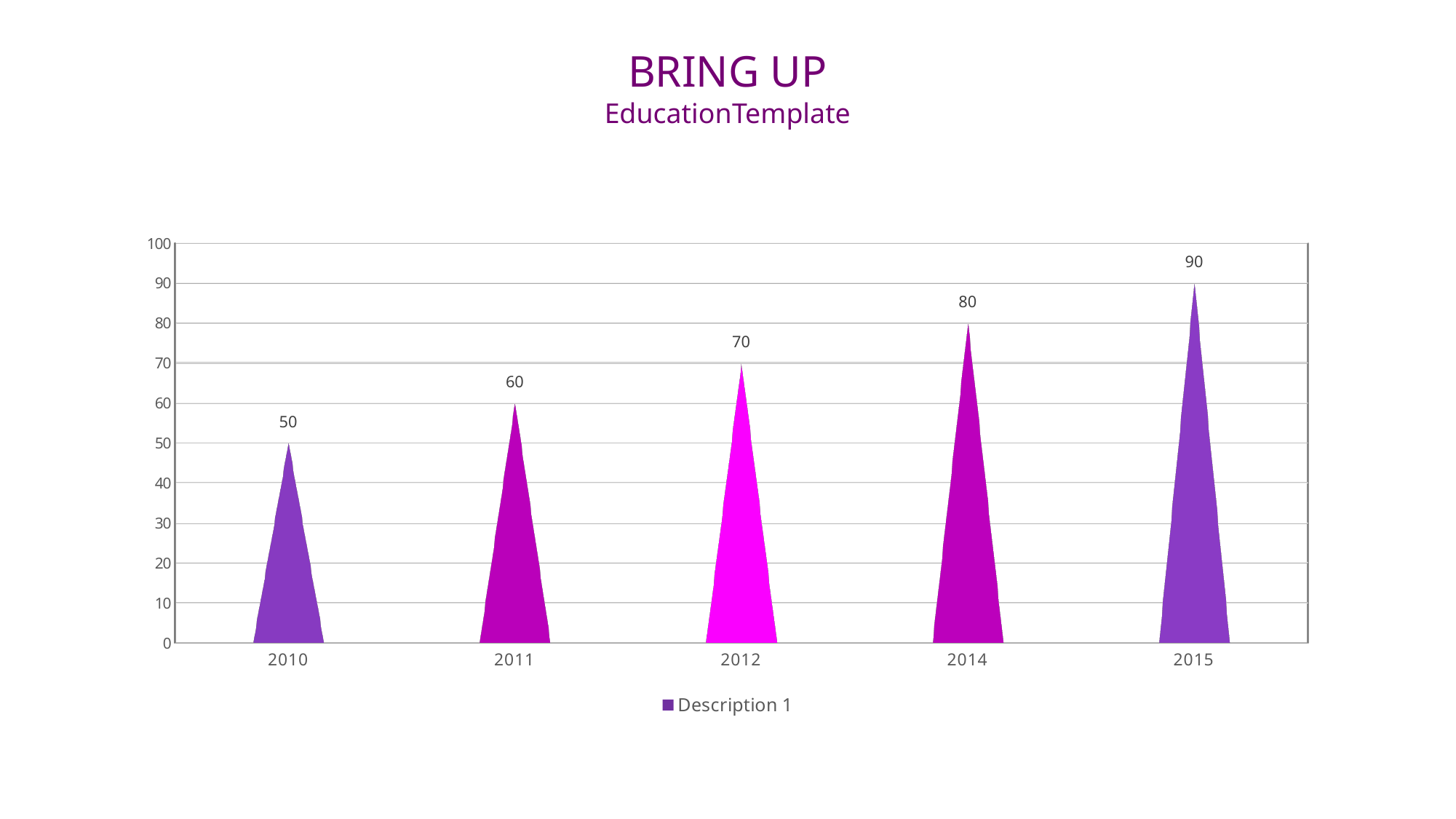
Which is larger, the value for 2012 or the value for 2014? 2014 What is the value for 2012? 70 What is the value for 2010? 50 Do the values rise or fall from 2010 to 2015? rise What is the name of the series in the legend? Description 1 Which year has the lowest value? 2010 How many years are shown on the x axis? 5 How many series does the legend list? 1 What is the difference between the values for 2014 and 2011? 20 Which year has the highest value? 2015 What is the value for 2015? 90 What kind of chart is shown? bar chart